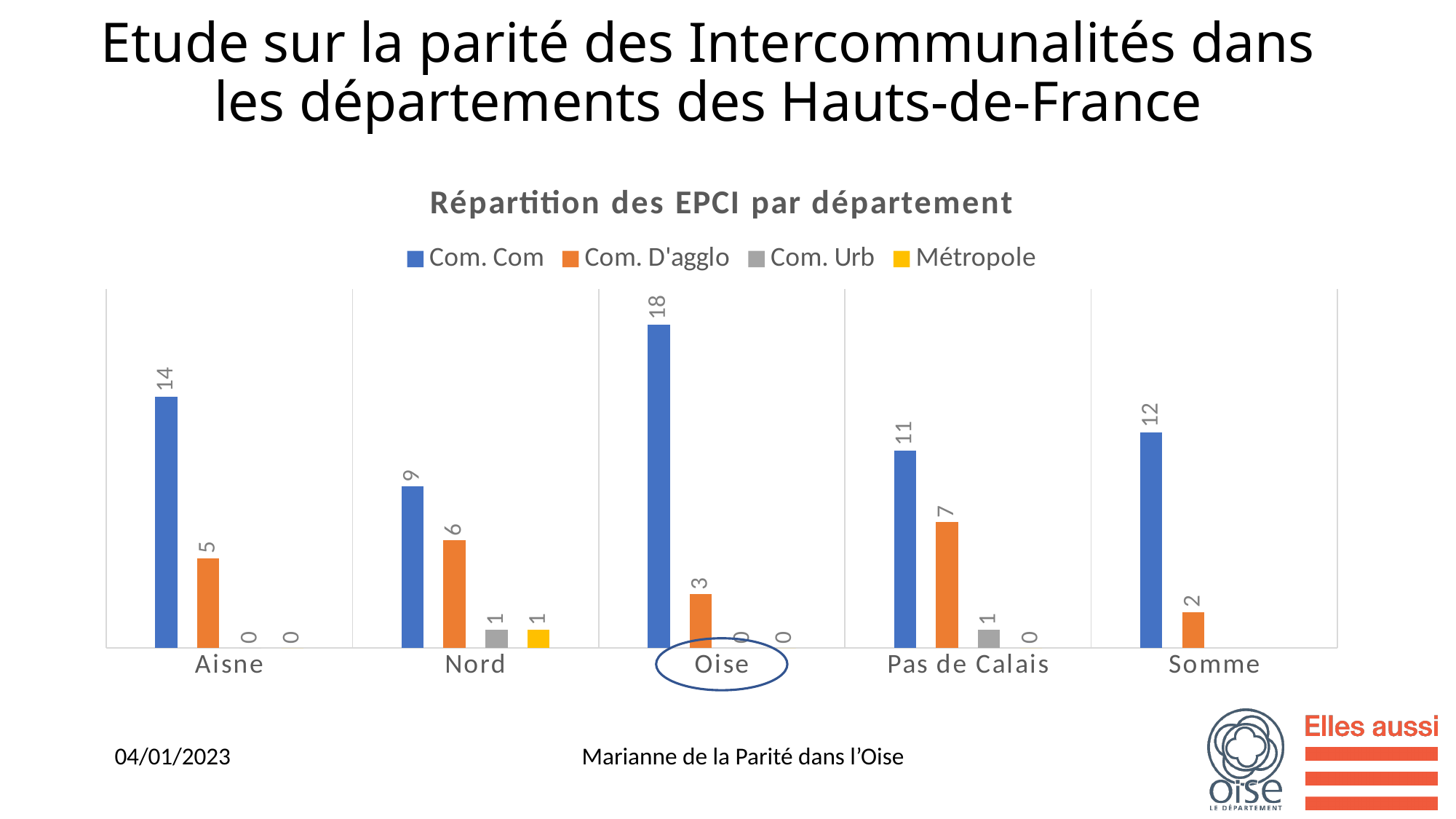
What is the value of Com. Urb for Nord? 1 What is the value of Métropole for Nord? 1 Which département has the lowest Com. D'agglo value? Somme What is the title of the chart? Répartition des EPCI par département What is the value of Com. D'agglo for Pas de Calais? 7 Which is larger, the Com. D'agglo value for Nord or for Aisne? Nord What is the difference between the Com. Com values for Oise and Aisne? 4 How many series does the legend list? 4 How many départements are shown on the x axis? 5 Which département has the highest Com. Com value? Oise What kind of chart is shown on the slide? Bar chart What is the value of Com. Com for Oise? 18